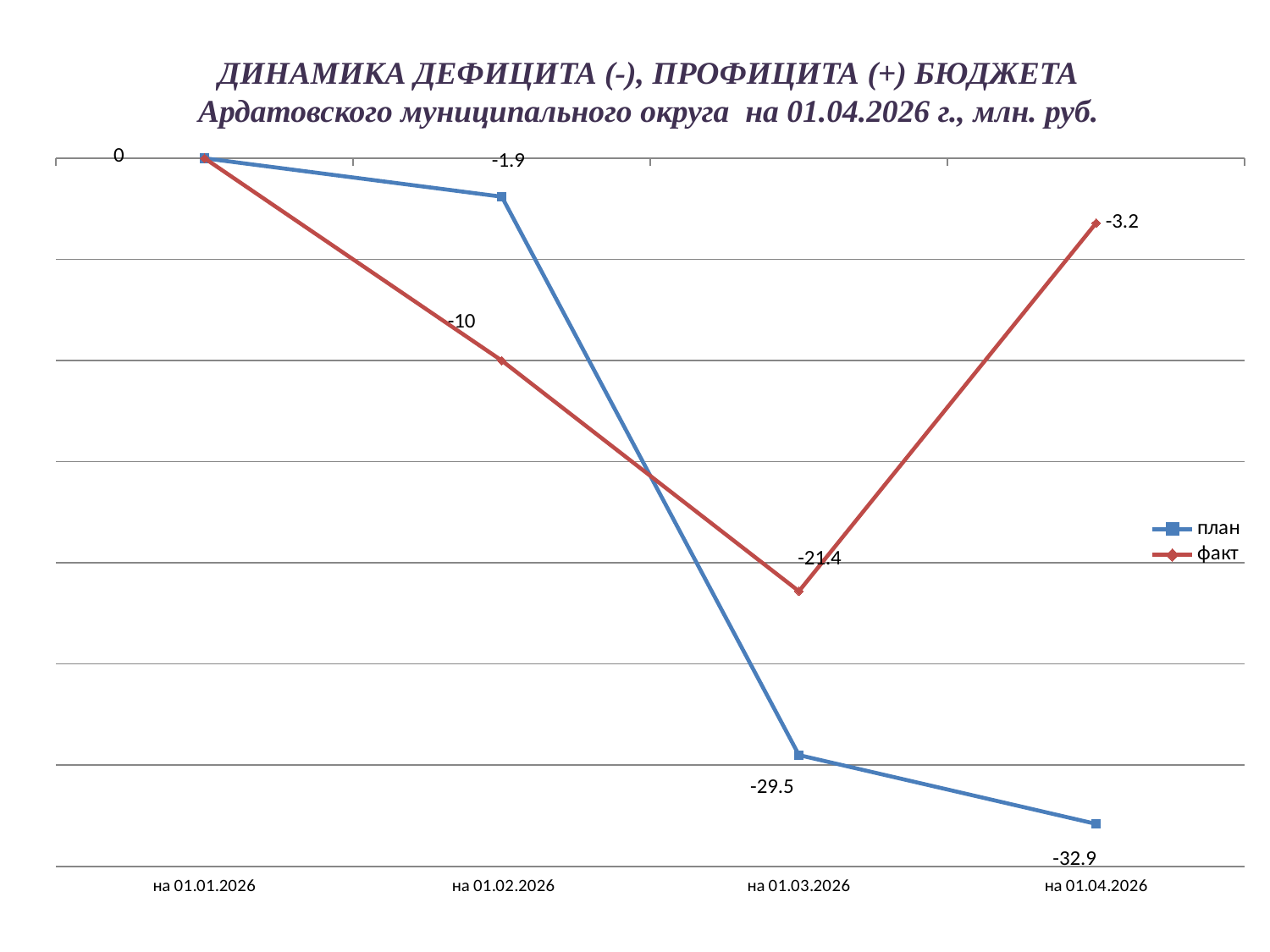
How many dates are shown on the x axis? 4 At на 01.03.2026, which series has the higher value, план or факт? факт How many series does the legend list? 2 What is the value of the план series at на 01.04.2026? -32.9 What kind of chart is shown on the slide? line chart At which date does the план series reach its lowest value? на 01.04.2026 What is the value of the факт series at на 01.02.2026? -10 What is the difference between the факт and план values at на 01.04.2026? 29.7 What is the value of the факт series at на 01.03.2026? -21.4 At which date does the факт series reach its lowest value? на 01.03.2026 What is the value of the план series at на 01.02.2026? -1.9 What is the value of the факт series at на 01.04.2026? -3.2